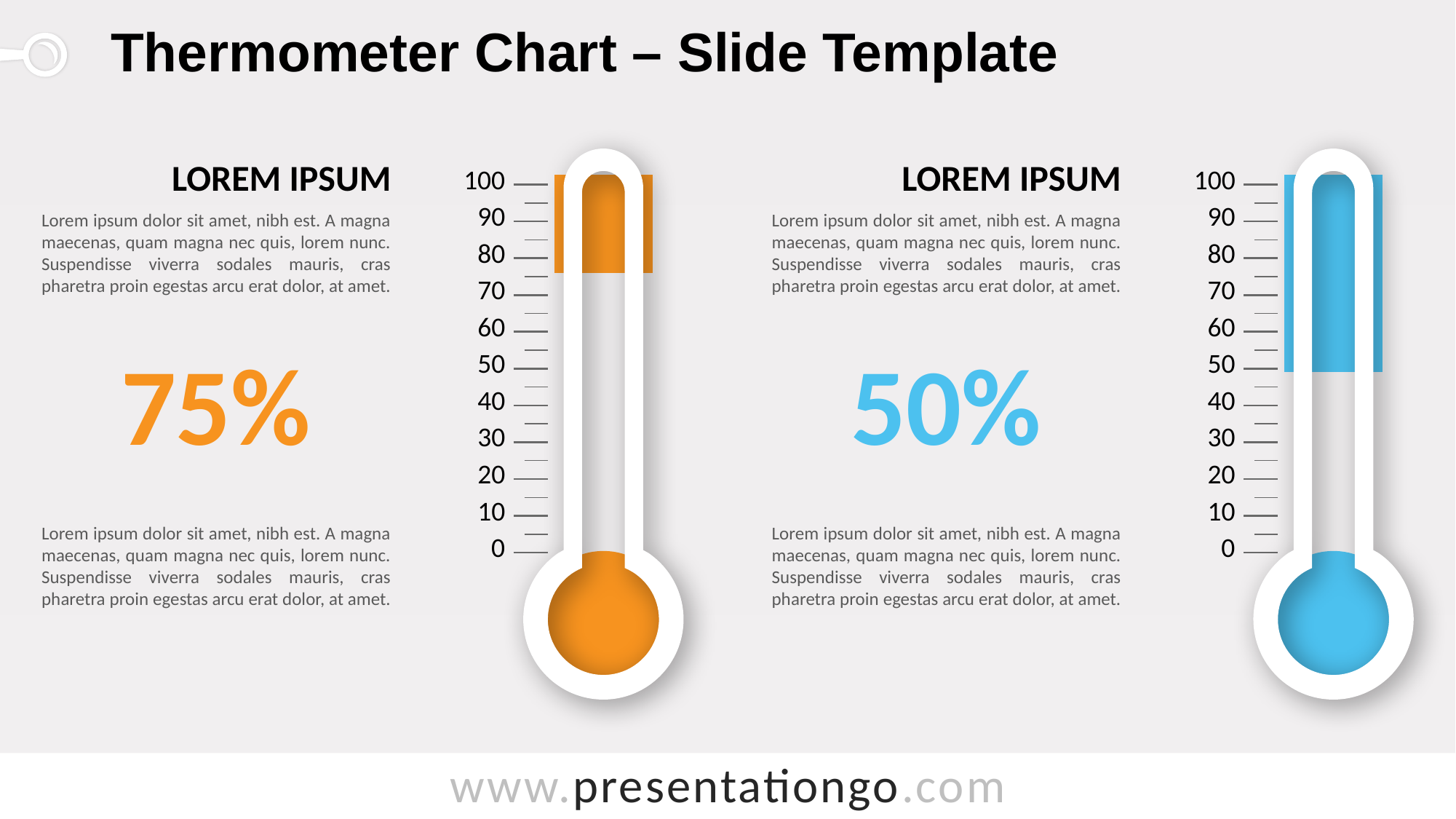
What is the highest tick value on the scale of the left thermometer chart? 100 What value is shown for the left (orange) thermometer chart? 75% What is the difference between the value on the left thermometer chart and the value on the right thermometer chart? 25% What kind of chart is used on this slide? thermometer chart Is the value shown on the left thermometer chart greater or less than 60? greater What is the lowest tick value on the scale of the right thermometer chart? 0 What colour is the fill of the right thermometer chart? blue What value is shown for the right (blue) thermometer chart? 50% What is the title of the slide? Thermometer Chart – Slide Template Is the value shown on the right thermometer chart greater or less than 70? less How many thermometer charts are on the slide? 2 Which thermometer chart shows the larger value, the left one or the right one? the left one